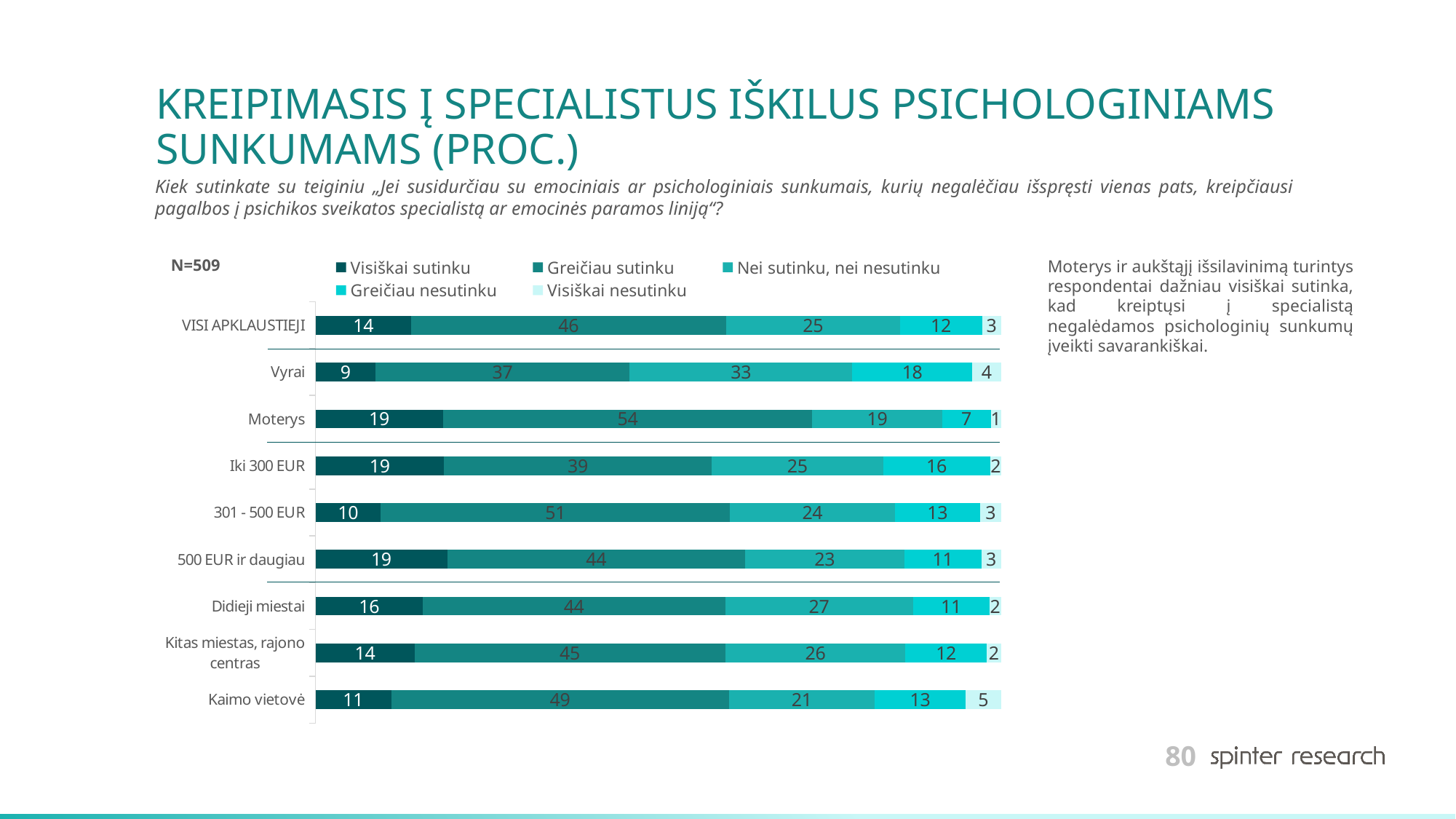
What is the sample size (N) shown on the slide? N=509 What kind of chart is shown on the slide? Stacked bar chart What is the value of "Visiškai sutinku" for "Moterys"? 19 Which category has the lowest value for "Visiškai sutinku"? Vyrai Which is larger: the "Nei sutinku, nei nesutinku" value for "Didieji miestai" or for "Kaimo vietovė"? Didieji miestai How many series does the legend list? 5 Which category has the highest value for "Greičiau sutinku"? Moterys What is the value of "Greičiau sutinku" for "301 - 500 EUR"? 51 What is the difference between the "Greičiau nesutinku" values for "Vyrai" and "Moterys"? 11 How many categories (respondent groups) are shown on the chart? 9 What is the value of "Visiškai nesutinku" for "Kaimo vietovė"? 5 What is the value of "Nei sutinku, nei nesutinku" for "Vyrai"? 33